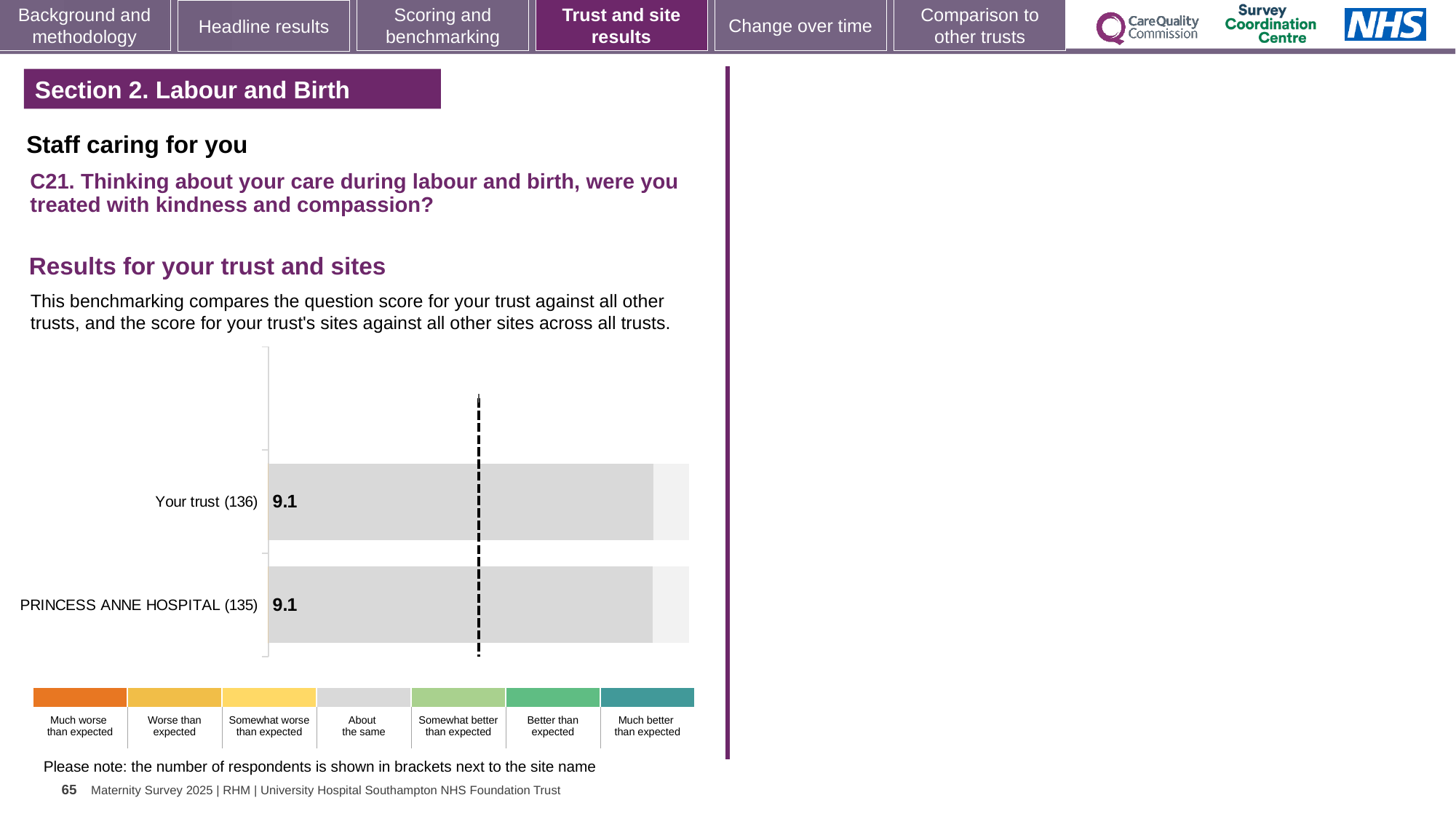
Which site is listed below Your trust in the chart? PRINCESS ANNE HOSPITAL (135) What is the score shown for Your trust (136)? 9.1 How many bars are plotted in the chart? 2 How many respondents are shown in brackets for PRINCESS ANNE HOSPITAL? 135 What is the score shown for PRINCESS ANNE HOSPITAL (135)? 9.1 What is the difference between the score for Your trust (136) and the score for PRINCESS ANNE HOSPITAL (135)? 0 What kind of chart is shown on the slide? Bar chart Is the score for Your trust (136) the same as the score for PRINCESS ANNE HOSPITAL (135)? Yes How many respondents are shown in brackets for Your trust? 136 How many colour categories are shown in the key beneath the chart? 7